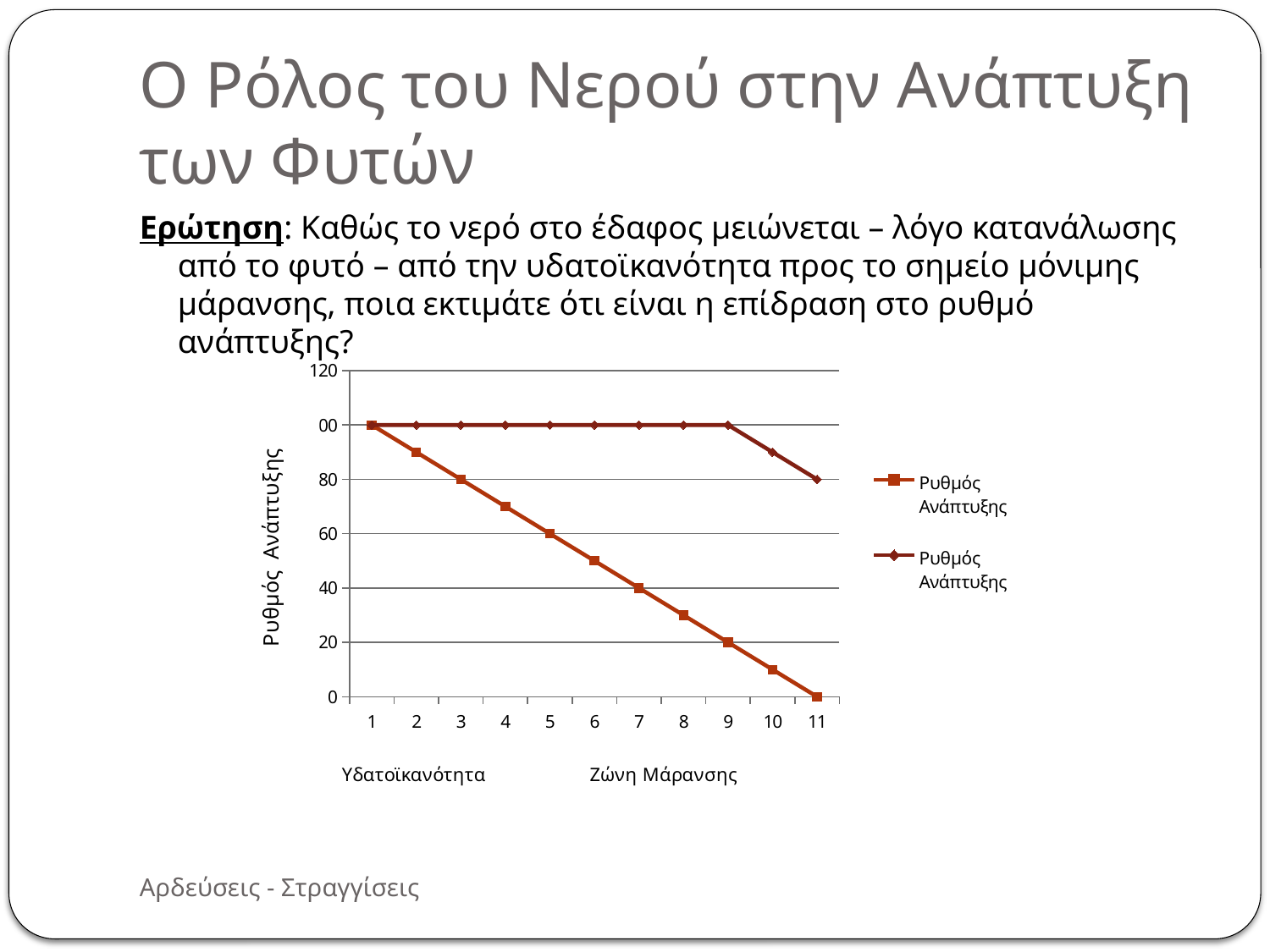
What is the value of the series with square markers at x = 3? 80 Is the value of the series with square markers at x = 6 greater or less than 60? less How many series does the chart's legend list? 2 What is the value of the series with diamond markers at x = 11? 80 How many points are plotted along the x axis of the chart? 11 Does the series with square markers rise or fall as x increases from 1 to 11? fall What is the difference between the values of the series with square markers at x = 3 and at x = 9? 60 What is the value of the series with square markers at x = 11? 0 At x = 5, which series has the higher value: the one with square markers or the one with diamond markers? the one with diamond markers What is the value of the series with square markers at x = 7? 40 What kind of chart is shown on the slide? line chart What is the title of the chart's vertical axis? Ρυθμός Ανάπτυξης